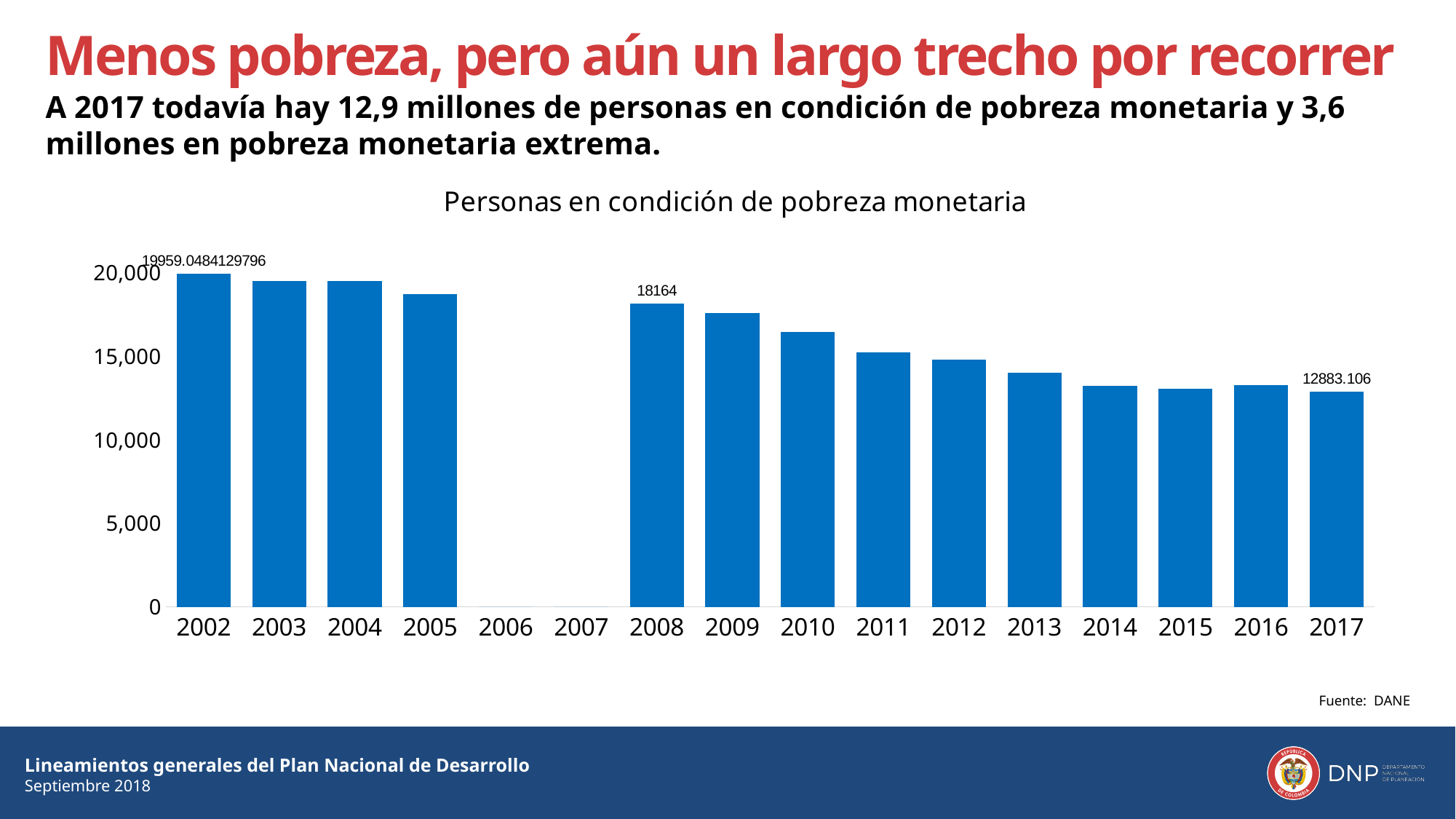
What is the value shown for 2017? 12883.106 Do the values generally rise or fall from 2008 to 2017? fall What is the value shown for 2008? 18164 What is the title of the chart? Personas en condición de pobreza monetaria What is the difference between the values for 2008 and 2017? 5280.894 What is the value shown for 2002? 19959.0484129796 Which is larger, the value for 2003 or the value for 2009? 2003 Is the value for 2014 greater or less than 15,000? less Which year has the highest value in the chart? 2002 Is the value for 2005 greater or less than 15,000? greater What kind of chart is shown on the slide? bar chart Which years on the x axis have no bar plotted? 2006 and 2007